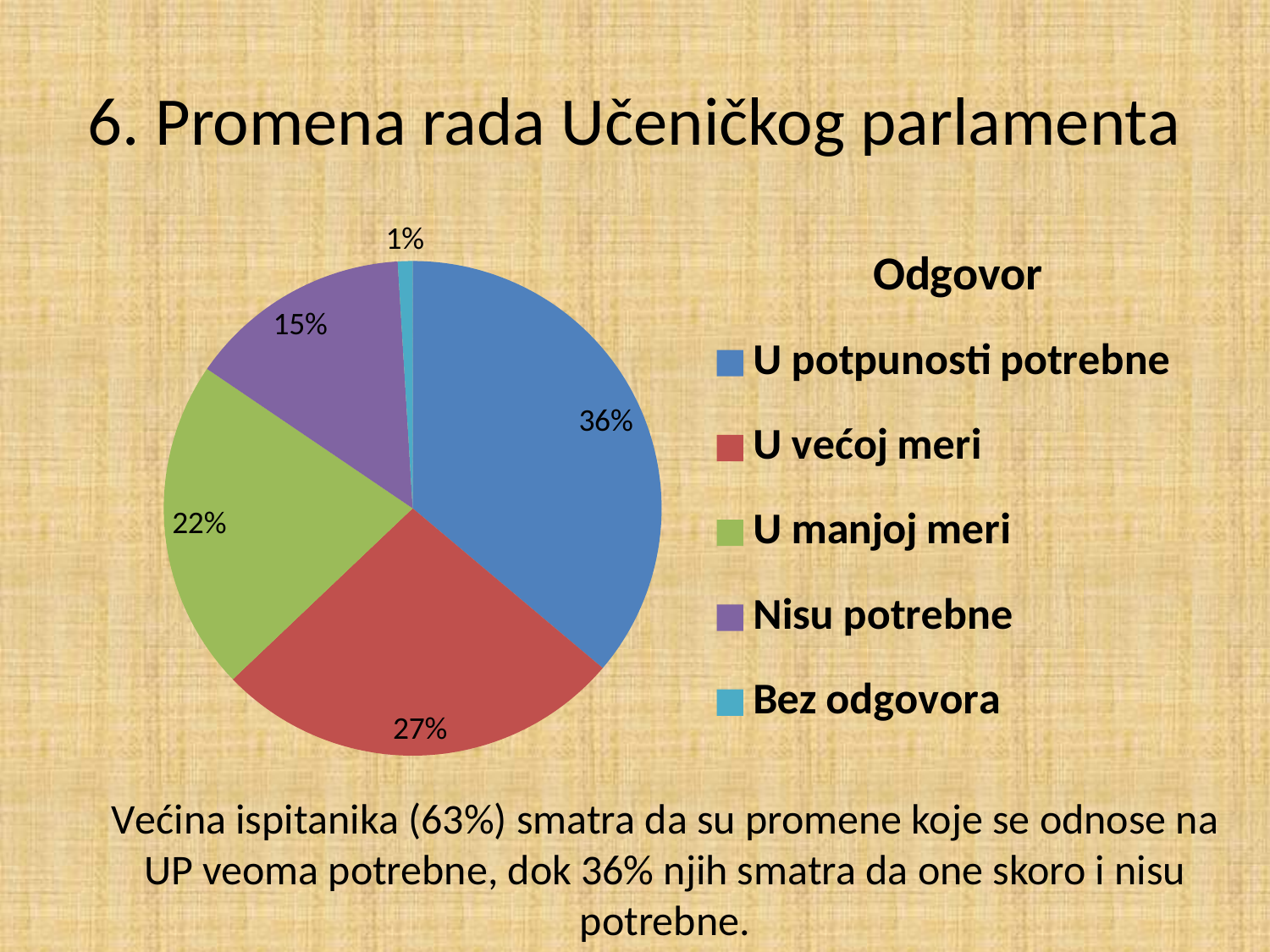
Which category has the largest slice of the pie? U potpunosti potrebne Which category has the smallest slice of the pie? Bez odgovora What is the difference between the shares of "U potpunosti potrebne" and "Nisu potrebne"? 21% How many categories does the legend list? 5 What share of the pie does "Nisu potrebne" represent? 15% Which is larger, the share for "U većoj meri" or the share for "U manjoj meri"? U većoj meri What share of the pie does "U manjoj meri" represent? 22% What share of the pie does "U potpunosti potrebne" represent? 36% What type of chart is shown on the slide? pie chart What is the title of the legend? Odgovor